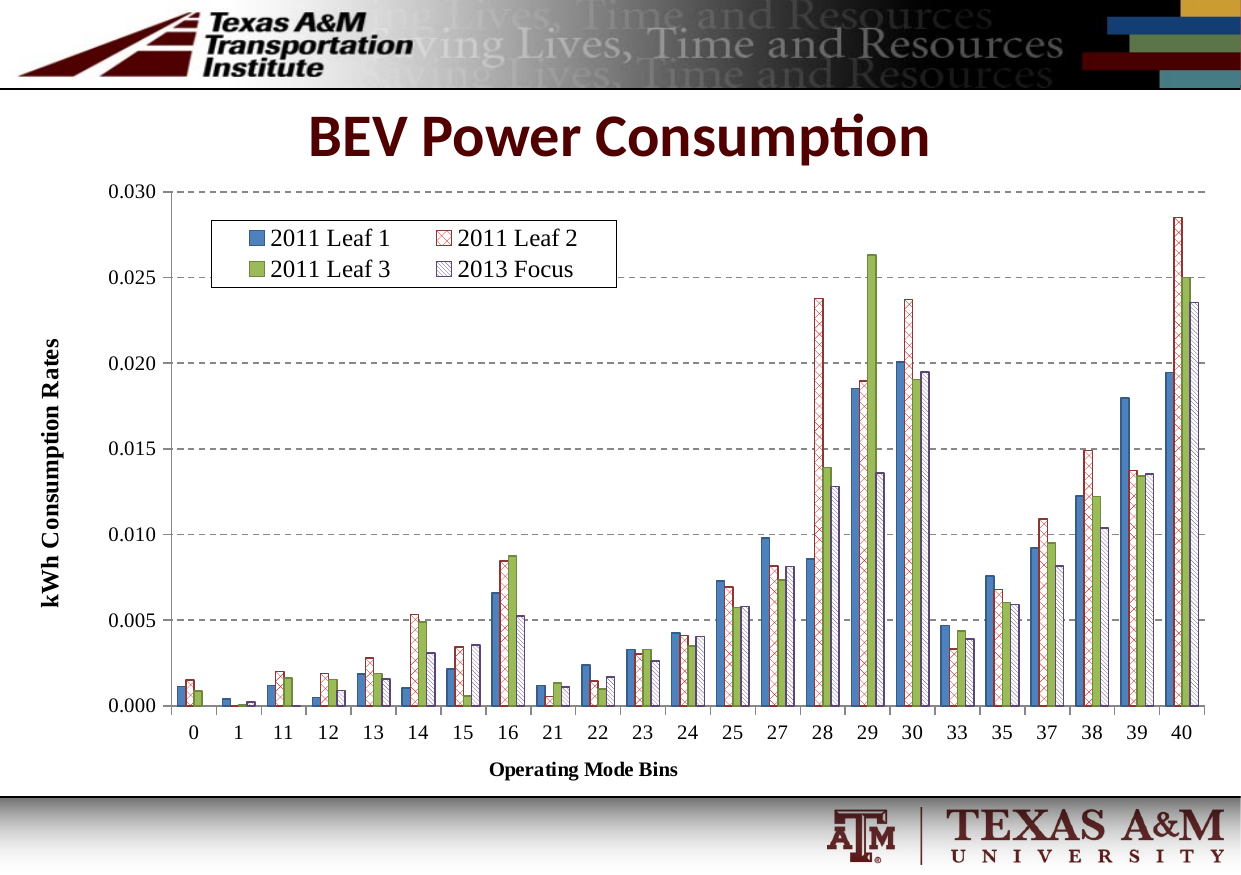
What is the label of the y axis? kWh Consumption Rates In which operating mode bin does 2011 Leaf 3 reach its highest value? 29 In which operating mode bin does 2013 Focus reach its highest value? 40 How many series does the legend list? 4 In which operating mode bin does 2011 Leaf 2 reach its highest value? 40 How many operating mode bins are shown on the x axis? 23 Is the value for 2011 Leaf 2 in bin 28 greater or less than 0.020? greater In bin 28, which series has the larger value, 2011 Leaf 1 or 2011 Leaf 2? 2011 Leaf 2 What kind of chart is shown on the slide? bar chart What is the title of the chart? BEV Power Consumption Is the value for 2011 Leaf 1 in bin 16 greater or less than 0.005? greater In bin 39, which series has the larger value, 2011 Leaf 1 or 2011 Leaf 3? 2011 Leaf 1